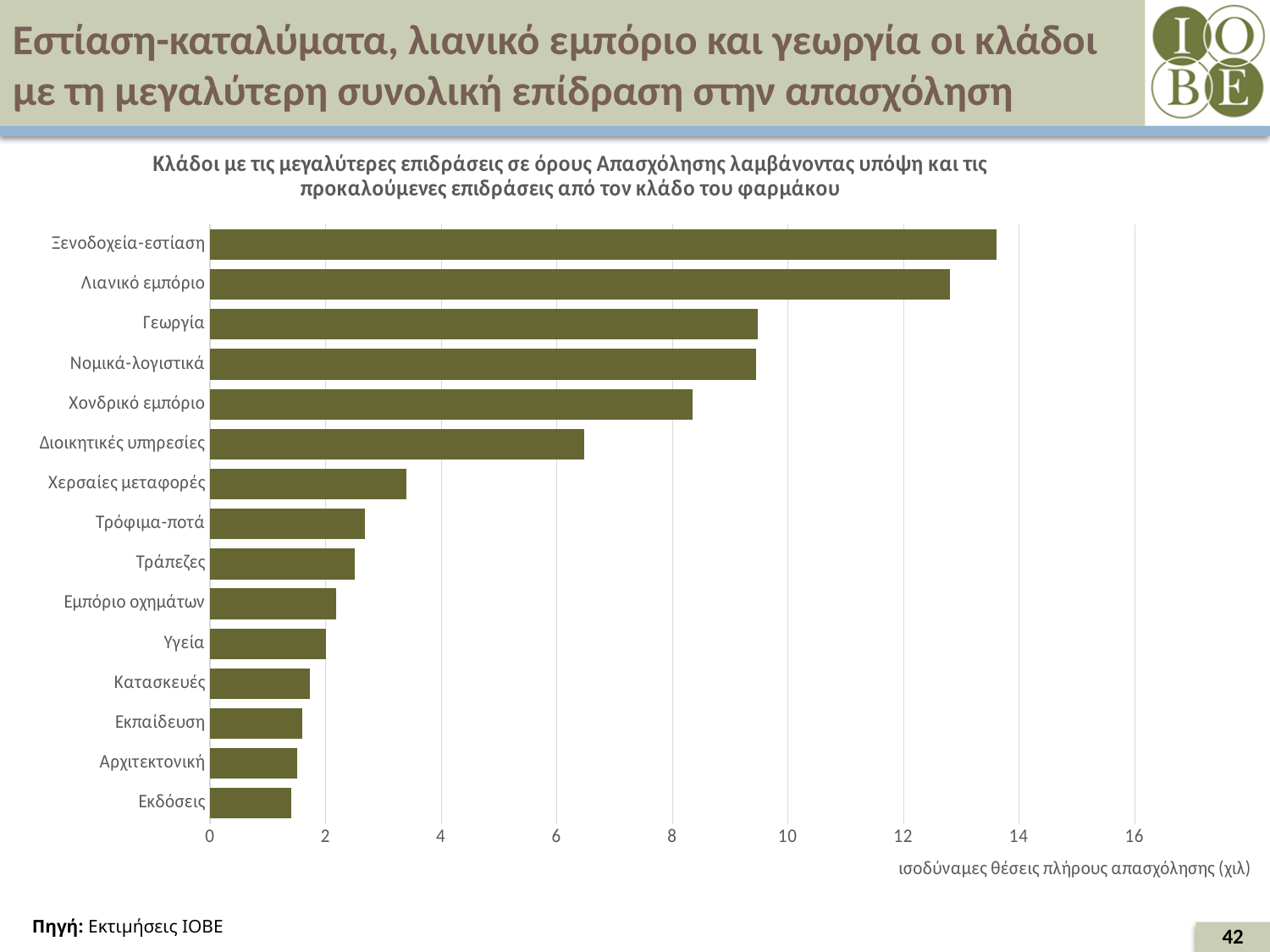
Is the value for Λιανικό εμπόριο greater or less than 14? less What kind of chart is shown on the slide? bar chart Is the value for Χερσαίες μεταφορές greater or less than 4? less What unit is given for the horizontal axis of the chart? ισοδύναμες θέσεις πλήρους απασχόλησης (χιλ) Which has a larger value, Λιανικό εμπόριο or Γεωργία? Λιανικό εμπόριο Is the value for Διοικητικές υπηρεσίες greater or less than 8? less Which has a larger value, Διοικητικές υπηρεσίες or Χερσαίες μεταφορές? Διοικητικές υπηρεσίες Which sector has the highest value in the chart? Ξενοδοχεία-εστίαση Which sector has the lowest value in the chart? Εκδόσεις How many sectors (categories) are plotted in the chart? 15